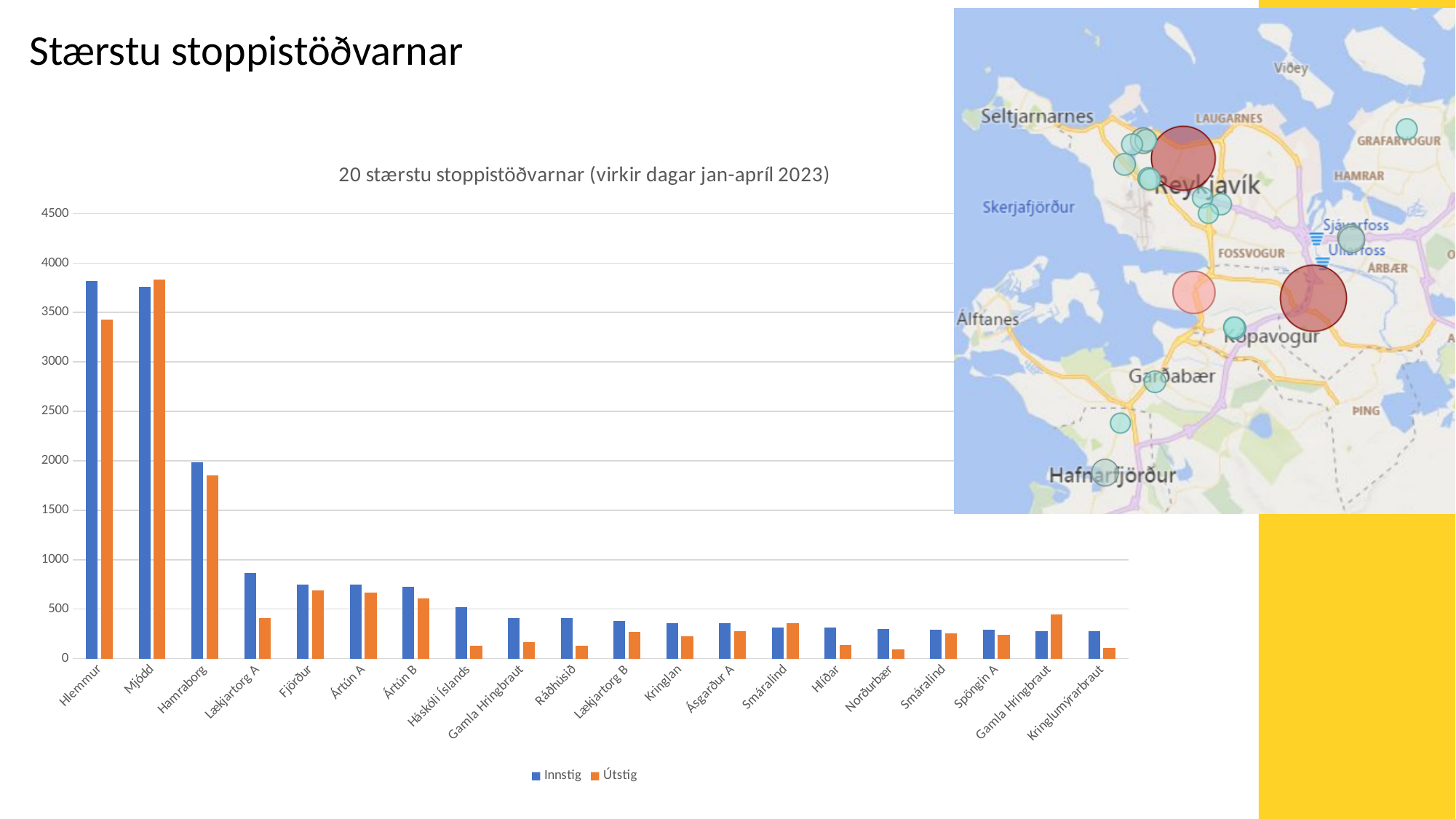
Is the Innstig value for Hlemmur greater or less than 3500? greater For Lækjartorg A, which is larger: Innstig or Útstig? Innstig Which stop has the highest Útstig value? Mjódd Is the Útstig value for Háskóli Íslands greater or less than 500? less What kind of chart is shown on the slide? bar chart Is the Innstig value for Lækjartorg A greater or less than 500? greater What is the title of the chart? 20 stærstu stoppistöðvarnar (virkir dagar jan-apríl 2023) Do the Innstig values generally rise or fall from left to right along the x axis? fall How many series does the chart legend list? 2 How many stops (categories) are plotted on the x axis of the chart? 20 For Hlemmur, which is larger: Innstig or Útstig? Innstig